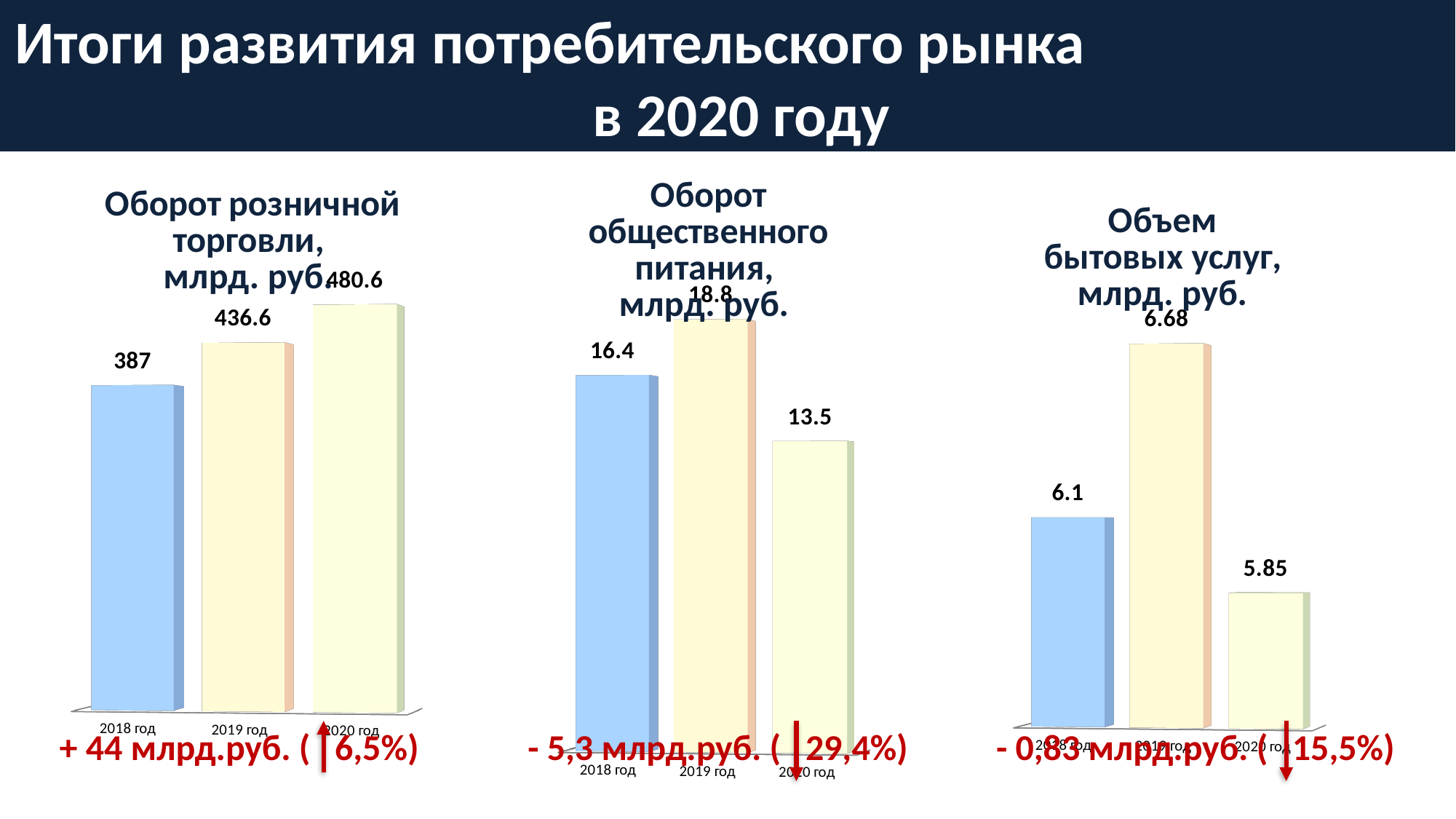
In the left chart (Оборот розничной торговли), what is the difference between the 2020 год and 2019 год values? 44 In the left chart (Оборот розничной торговли), what is the value for 2020 год? 480.6 In the left chart (Оборот розничной торговли), what is the value for 2018 год? 387 In the left chart (Оборот розничной торговли), which year has the lowest value? 2018 год In the middle chart (Оборот общественного питания), what is the difference between the 2018 год and 2020 год values? 2.9 In the right chart (Объем бытовых услуг), which is larger, the value for 2018 год or 2020 год? 2018 год How many bars are shown in the left chart (Оборот розничной торговли)? 3 In the middle chart (Оборот общественного питания), which year has the highest value? 2019 год What type of chart is the middle chart (Оборот общественного питания)? Bar chart In the right chart (Объем бытовых услуг), which year has the highest value? 2019 год In the right chart (Объем бытовых услуг), what is the value for 2020 год? 5.85 In the middle chart (Оборот общественного питания), what is the value for 2019 год? 18.8